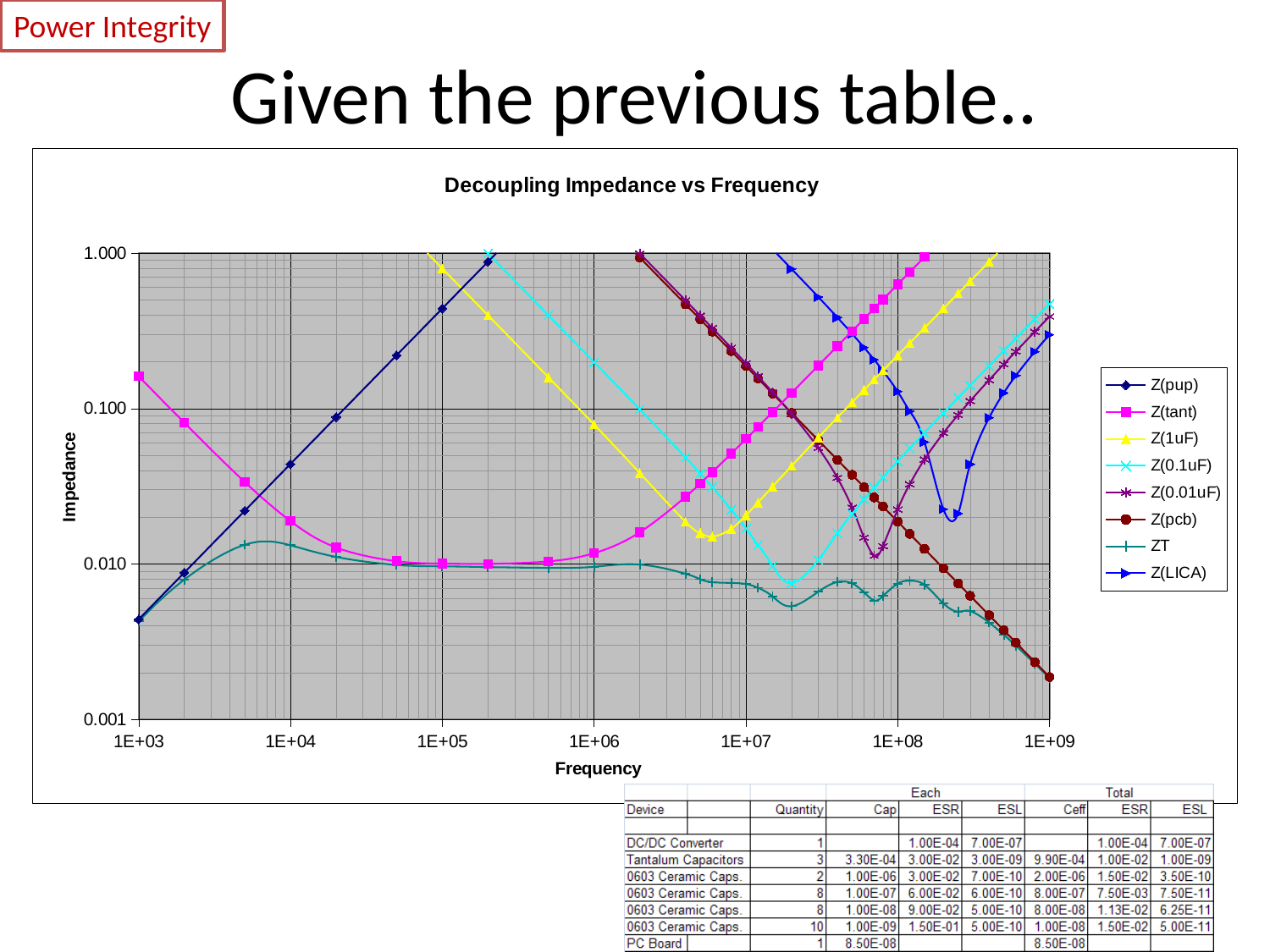
At 1E+06, which is larger: Z(0.1uF) or Z(tant)? Z(0.1uF) What is the label of the vertical axis of the chart? Impedance What is the title of the chart? Decoupling Impedance vs Frequency Is the value of Z(tant) at 1E+03 greater or less than 0.100? greater At 1E+03, which is larger: Z(tant) or Z(pup)? Z(tant) Is the value of ZT at 1E+05 greater or less than 0.100? less How many series does the chart legend list? 8 Does the Z(pcb) series rise or fall as frequency increases? falls Does the Z(pup) series rise or fall as frequency increases? rises What kind of chart is shown on the slide? line chart Is the value of Z(pup) at 1E+03 greater or less than 0.010? less